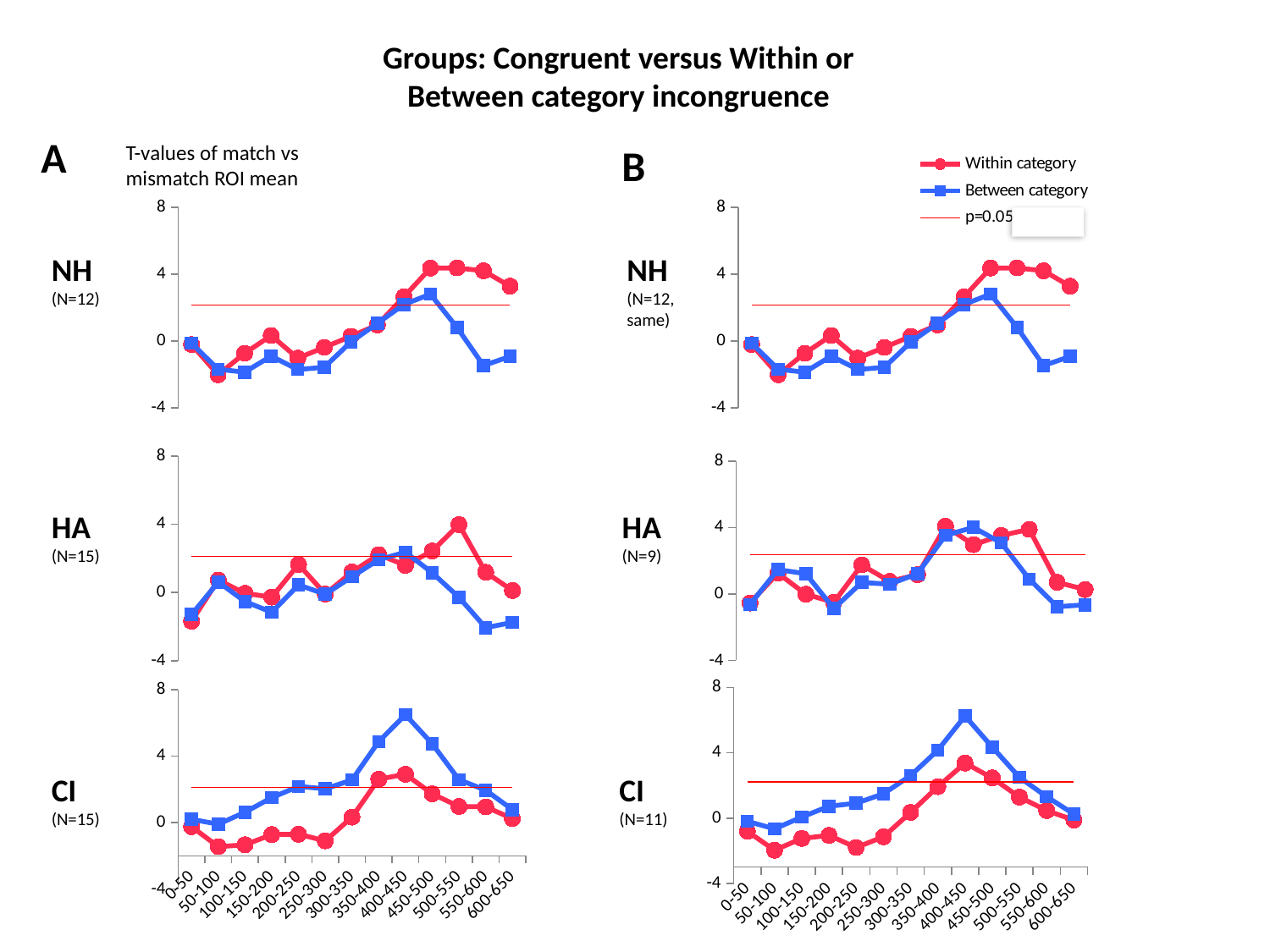
What is the sample size (N) given for the HA chart in panel B? N=9 In the panel A CI (N=15) chart, is the Between category value at 400-450 greater or less than 4? greater In the panel A CI (N=15) chart, does the Between category line rise or fall from 0-50 to 400-450? rise How many time-window categories are shown along the x axis of the CI chart in panel A? 13 In the panel A CI (N=15) chart, is the Within category value at 50-100 greater or less than 0? less In the panel A NH (N=12) chart, is the Between category value at 550-600 greater or less than 0? less In the panel A HA (N=15) chart, which series has the higher value at 500-550, Within category or Between category? Within category In the panel B CI (N=11) chart, which series has the higher value at 400-450, Within category or Between category? Between category According to the legend, what colour is the Within category series? Red What kind of chart is used in each of the six panels on the slide? Line chart How many entries does the legend in panel B list? 3